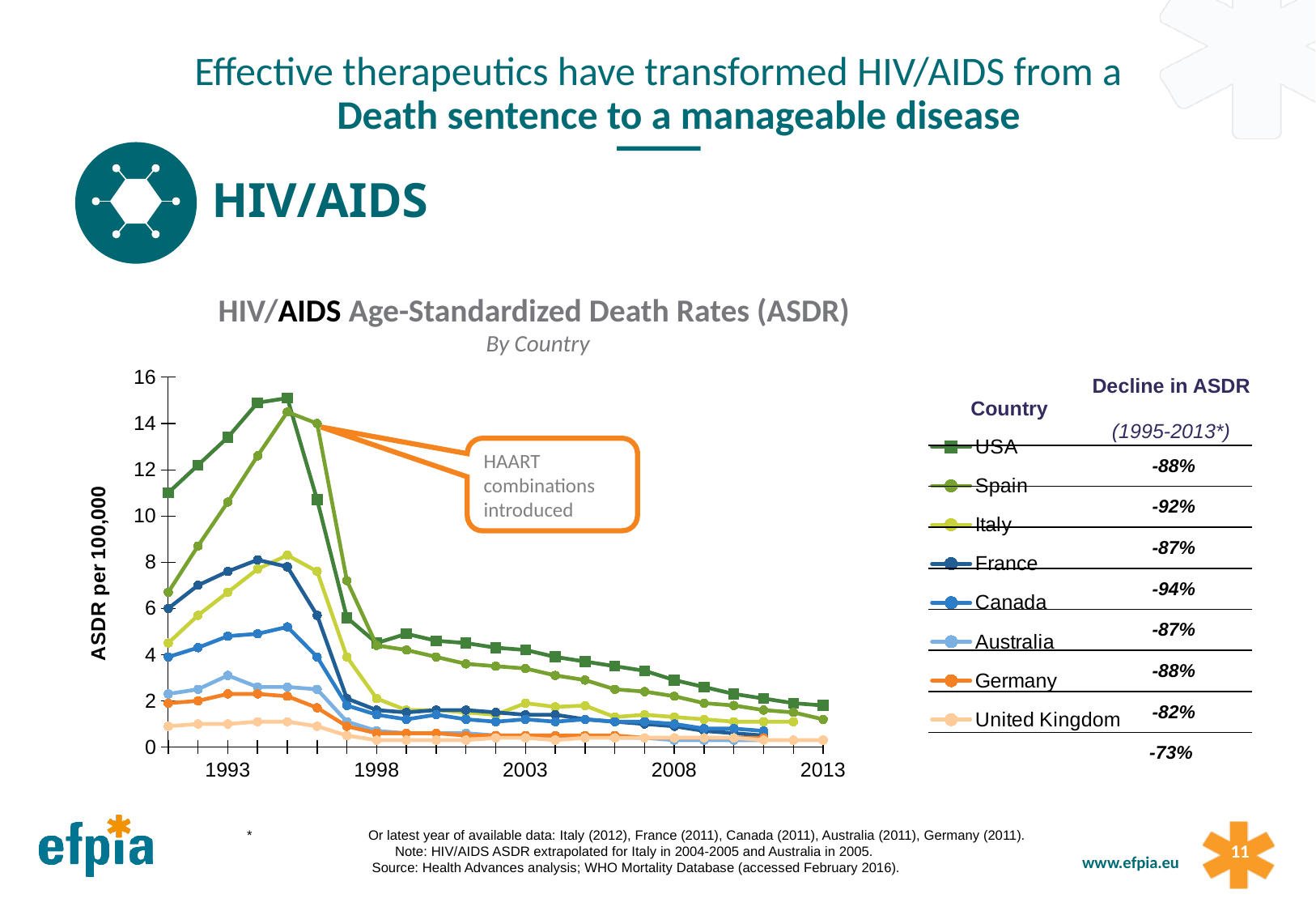
In 1993, which country had the higher ASDR, USA or France? USA Is the United Kingdom's ASDR in 1993 greater or less than 2? less What event does the callout annotation on the chart mark? HAART combinations introduced Is Spain's ASDR in 2013 greater or less than 2? less How many year labels are shown on the x-axis of the chart? 5 What is the label on the y-axis of the HIV/AIDS ASDR chart? ASDR per 100,000 How many countries (series) are plotted in the HIV/AIDS ASDR chart? 8 Is the USA's ASDR at its 1995 peak greater or less than 14? greater Which country had the highest ASDR at the start of the series (around 1991)? USA What type of chart is used to show HIV/AIDS Age-Standardized Death Rates by country? Line chart Does the USA's ASDR rise or fall between 1995 and 2013? Fall